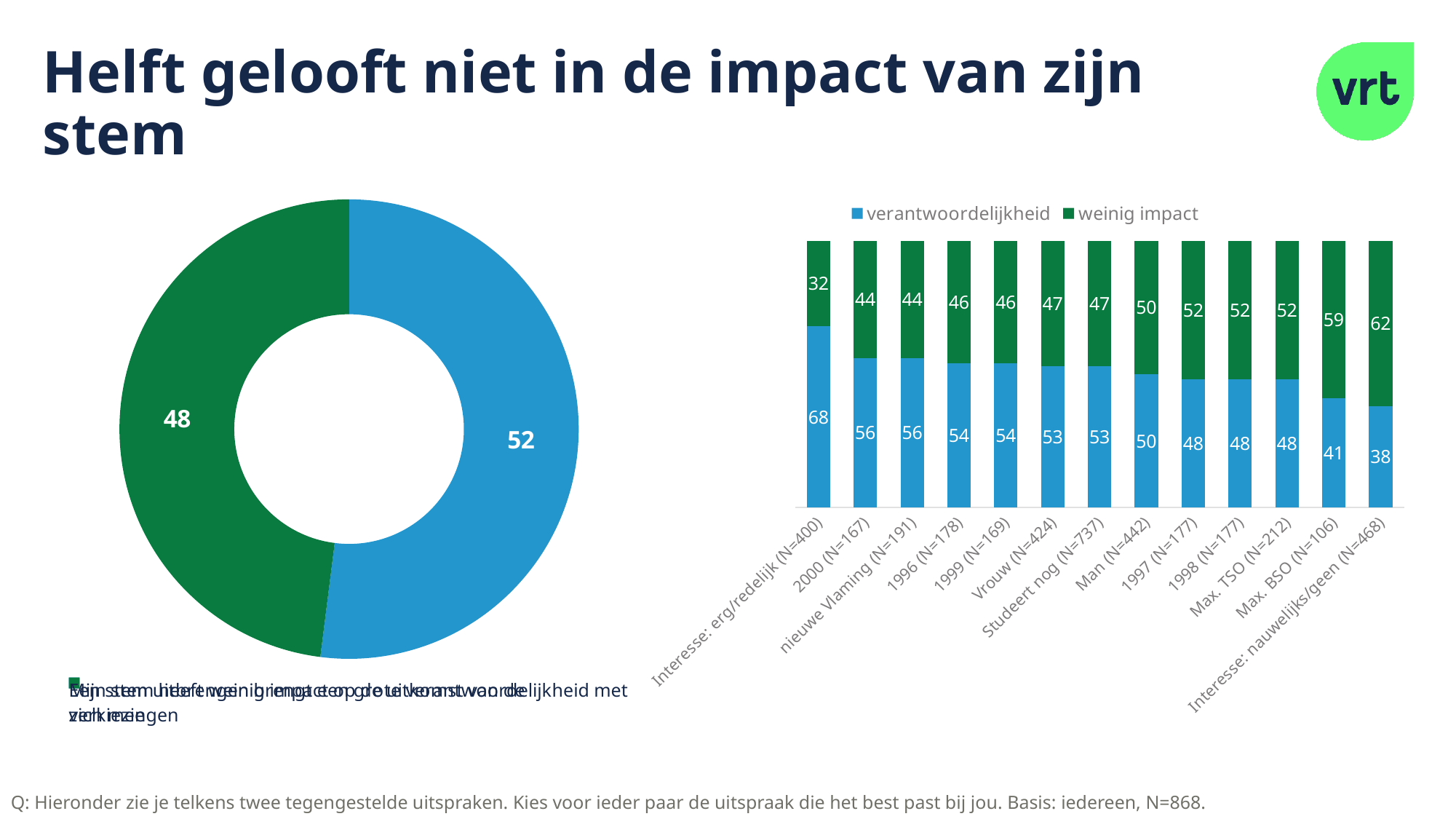
In the stacked bar chart on the right, what is the 'weinig impact' value for 'Max. BSO (N=106)'? 59 In the stacked bar chart on the right, which category has the lowest 'verantwoordelijkheid' value? Interesse: nauwelijks/geen (N=468) In the stacked bar chart on the right, what is the difference between the 'verantwoordelijkheid' values for 'Interesse: erg/redelijk (N=400)' and 'Interesse: nauwelijks/geen (N=468)'? 30 In the stacked bar chart on the right, which is larger: the 'verantwoordelijkheid' value for 'Man (N=442)' or for 'Max. TSO (N=212)'? Man (N=442) In the stacked bar chart on the right, what is the 'weinig impact' value for 'Vrouw (N=424)'? 47 How many series does the legend of the stacked bar chart on the right list? 2 In the stacked bar chart on the right, which category has the highest 'weinig impact' value? Interesse: nauwelijks/geen (N=468) In the donut chart on the left, what is the value of the blue slice? 52 How many categories are shown on the x axis of the stacked bar chart on the right? 13 What kind of chart is shown on the left of the slide? Donut chart In the stacked bar chart on the right, what is the 'verantwoordelijkheid' value for 'Interesse: erg/redelijk (N=400)'? 68 In the stacked bar chart on the right, what is the total of the stacked bar for '2000 (N=167)'? 100